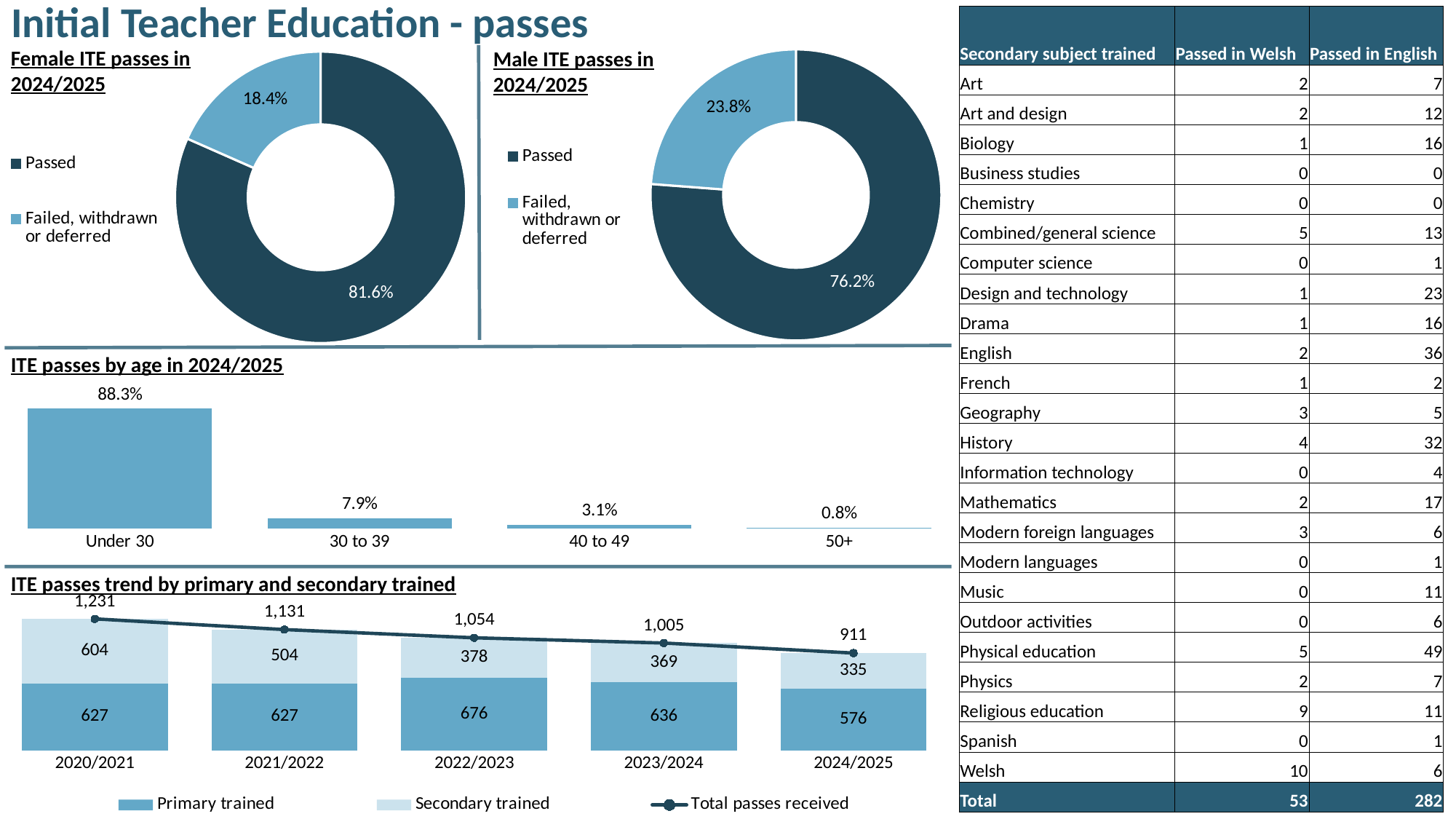
In the 'ITE passes trend by primary and secondary trained' chart, how many primary trained passes were there in 2022/2023? 676 In the 'ITE passes trend by primary and secondary trained' chart, do total passes received rise or fall from 2020/2021 to 2024/2025? Fall How many age groups are shown in the 'ITE passes by age in 2024/2025' chart? 4 In the 'ITE passes trend by primary and secondary trained' chart, what is the difference between secondary trained passes in 2020/2021 and 2024/2025? 269 In the 'ITE passes by age in 2024/2025' chart, which age group has the lowest share of passes? 50+ In the 'ITE passes by age in 2024/2025' chart, which age group has the highest share of passes? Under 30 What kind of chart is the 'Female ITE passes in 2024/2025' chart? Donut (pie) chart In the 'ITE passes by age in 2024/2025' chart, what is the value for the 30 to 39 age group? 7.9% How many series does the legend of the 'ITE passes trend by primary and secondary trained' chart list? 3 In the 'ITE passes trend by primary and secondary trained' chart, what was the total number of passes received in 2024/2025? 911 In the 'Female ITE passes in 2024/2025' chart, what share of female ITE candidates passed? 81.6% In the 'Male ITE passes in 2024/2025' chart, what share of male ITE candidates failed, withdrew or deferred? 23.8%